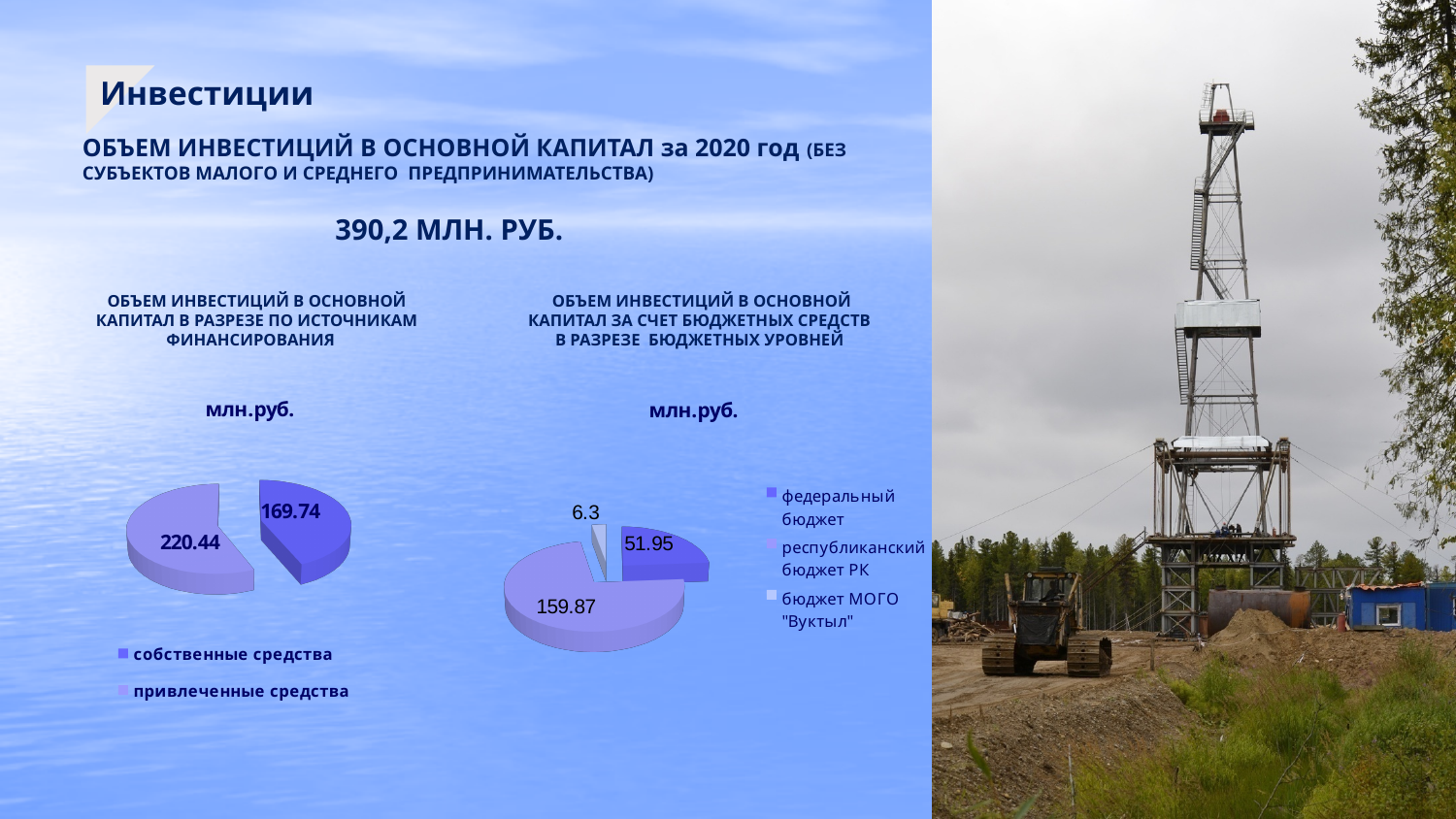
On the right pie chart (by budget levels), what is the value for федеральный бюджет? 51.95 What type of chart is used for both charts on the slide? pie chart On the right pie chart (by budget levels), how many categories does the legend list? 3 On the left pie chart (by sources of financing), how many slices does the pie have? 2 On the left pie chart (by sources of financing), what is the value for собственные средства? 169.74 On the left pie chart (by sources of financing), which category has the larger value? привлеченные средства On the left pie chart (by sources of financing), what is the difference between привлеченные средства and собственные средства? 50.70 On the right pie chart (by budget levels), what is the value for республиканский бюджет РК? 159.87 On the right pie chart (by budget levels), which is larger: федеральный бюджет or республиканский бюджет РК? республиканский бюджет РК On the right pie chart (by budget levels), which budget level has the smallest value? бюджет МОГО "Вуктыл" On the right pie chart (by budget levels), what is the value for бюджет МОГО "Вуктыл"? 6.3 On the left pie chart (by sources of financing), what is the value for привлеченные средства? 220.44